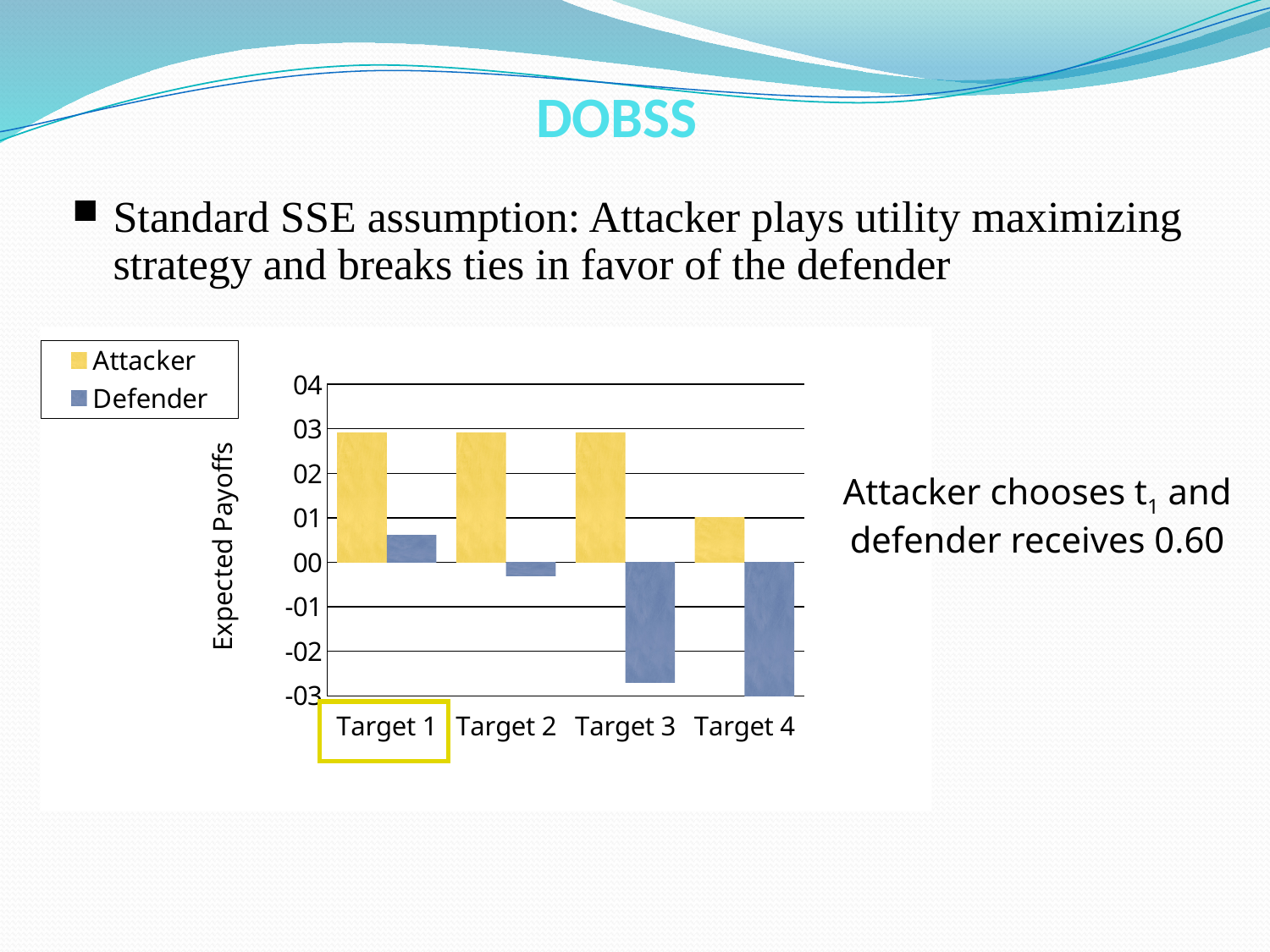
What kind of chart is shown on the slide? bar chart For which target is the Defender value highest? Target 1 For which target is the Defender value lowest? Target 4 What is the Attacker value for Target 4? 01 Is the Attacker value for Target 2 greater or less than 02? greater How many targets are shown on the x axis? 4 What is the label on the vertical axis? Expected Payoffs Is the Defender value for Target 3 greater or less than -02? less How many series does the legend list? 2 What are the two series named in the legend? Attacker and Defender For which target is the Attacker value lowest? Target 4